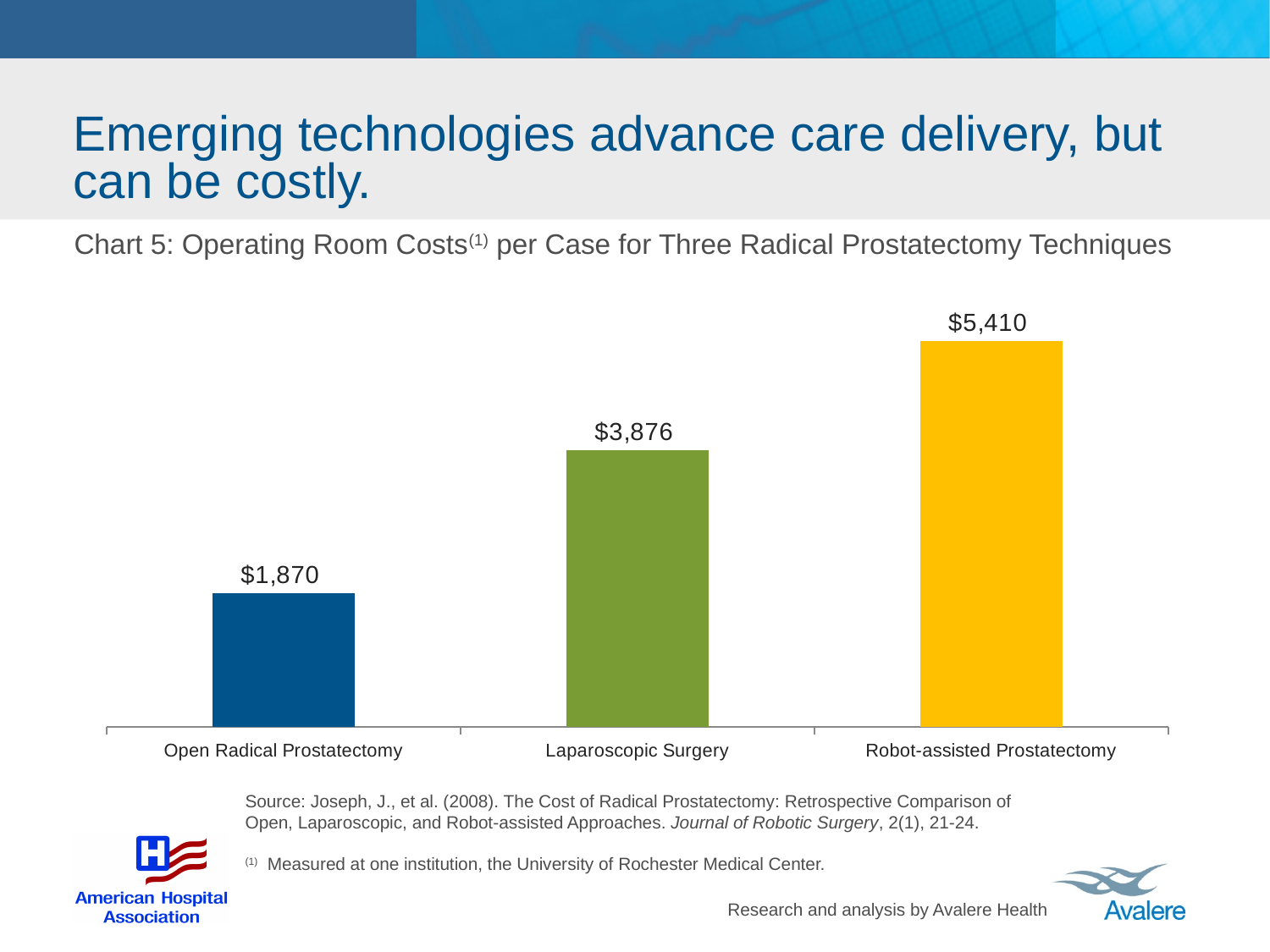
What is the operating room cost per case for Laparoscopic Surgery? $3,876 What is the operating room cost per case for Robot-assisted Prostatectomy? $5,410 What is the difference in operating room cost per case between Robot-assisted Prostatectomy and Open Radical Prostatectomy? $3,540 What is the difference in operating room cost per case between Laparoscopic Surgery and Open Radical Prostatectomy? $2,006 Do the operating room costs rise or fall from left to right across the techniques? Rise What is the operating room cost per case for Open Radical Prostatectomy? $1,870 How many prostatectomy techniques are shown in the chart? 3 Which has a higher operating room cost per case, Laparoscopic Surgery or Robot-assisted Prostatectomy? Robot-assisted Prostatectomy What type of chart is used to show the operating room costs? Bar chart What colour is the bar for Robot-assisted Prostatectomy? Yellow Which technique has the highest operating room cost per case? Robot-assisted Prostatectomy Which technique has the lowest operating room cost per case? Open Radical Prostatectomy